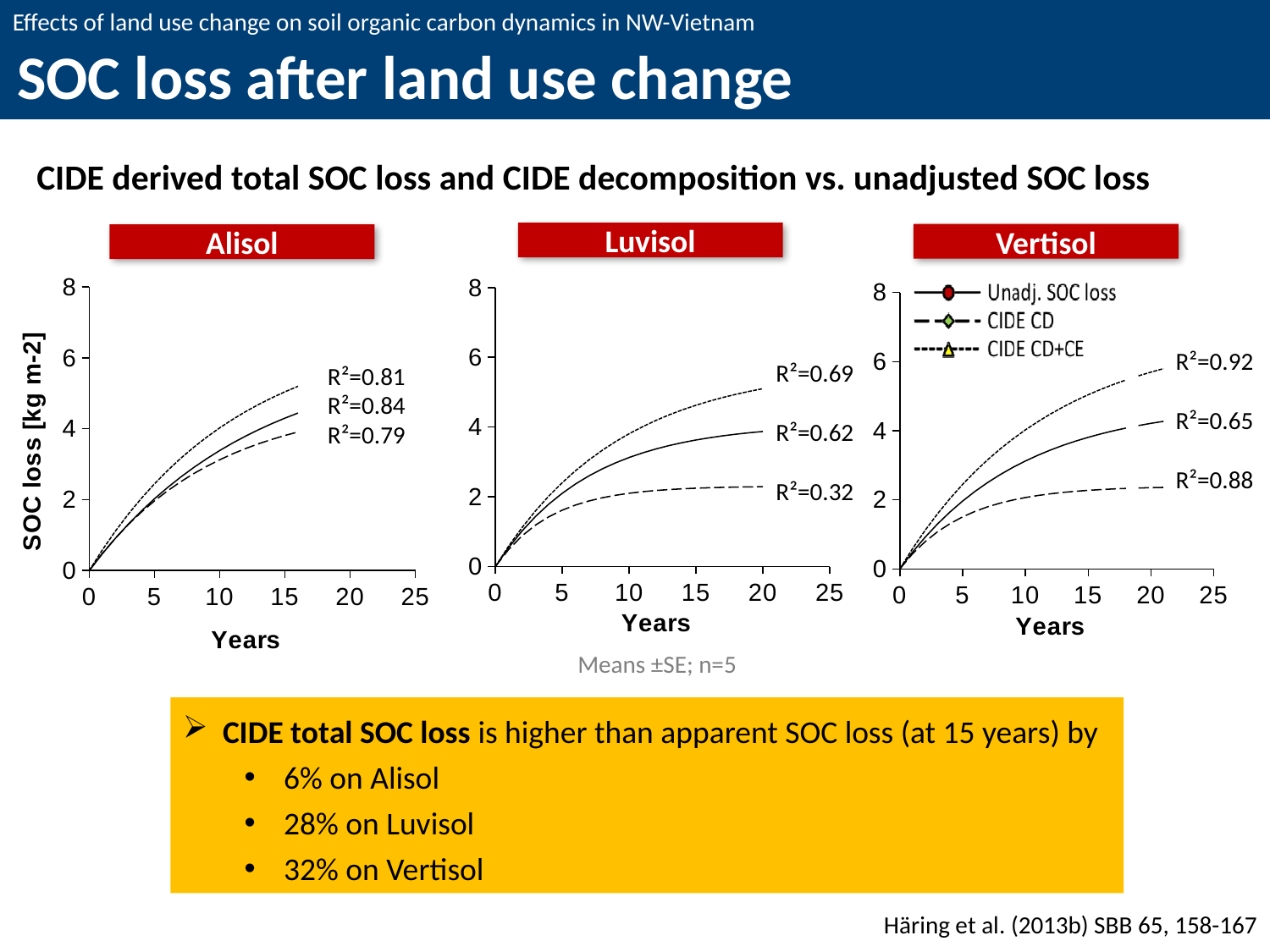
What kind of chart is used for the Alisol panel? line chart In the Vertisol chart, which line has the highest printed R² value? CIDE CD+CE (R²=0.92) In the Vertisol chart, is the value of the CIDE CD+CE (dotted) line at 20 years greater or less than 4? greater In the Luvisol chart, which line has the lowest printed R² value? CIDE CD (R²=0.32) What is the y-axis label on the Alisol chart? SOC loss [kg m-2] What are the three series named in the legend of the Vertisol chart? Unadj. SOC loss, CIDE CD, CIDE CD+CE In the Alisol chart, is the value of the Unadj. SOC loss (solid) line at 15 years greater or less than 2? greater In the Luvisol chart, what R² value is printed next to the lowest (dashed, CIDE CD) line? R²=0.32 In the Luvisol chart, does the Unadj. SOC loss line rise or fall as years increase? rise In the Vertisol chart at 20 years, which is larger: the CIDE CD+CE line or the CIDE CD line? CIDE CD+CE How many series does the legend in the Vertisol chart list? 3 In the Luvisol chart, is the value of the CIDE CD (dashed) line at 20 years greater or less than 4? less